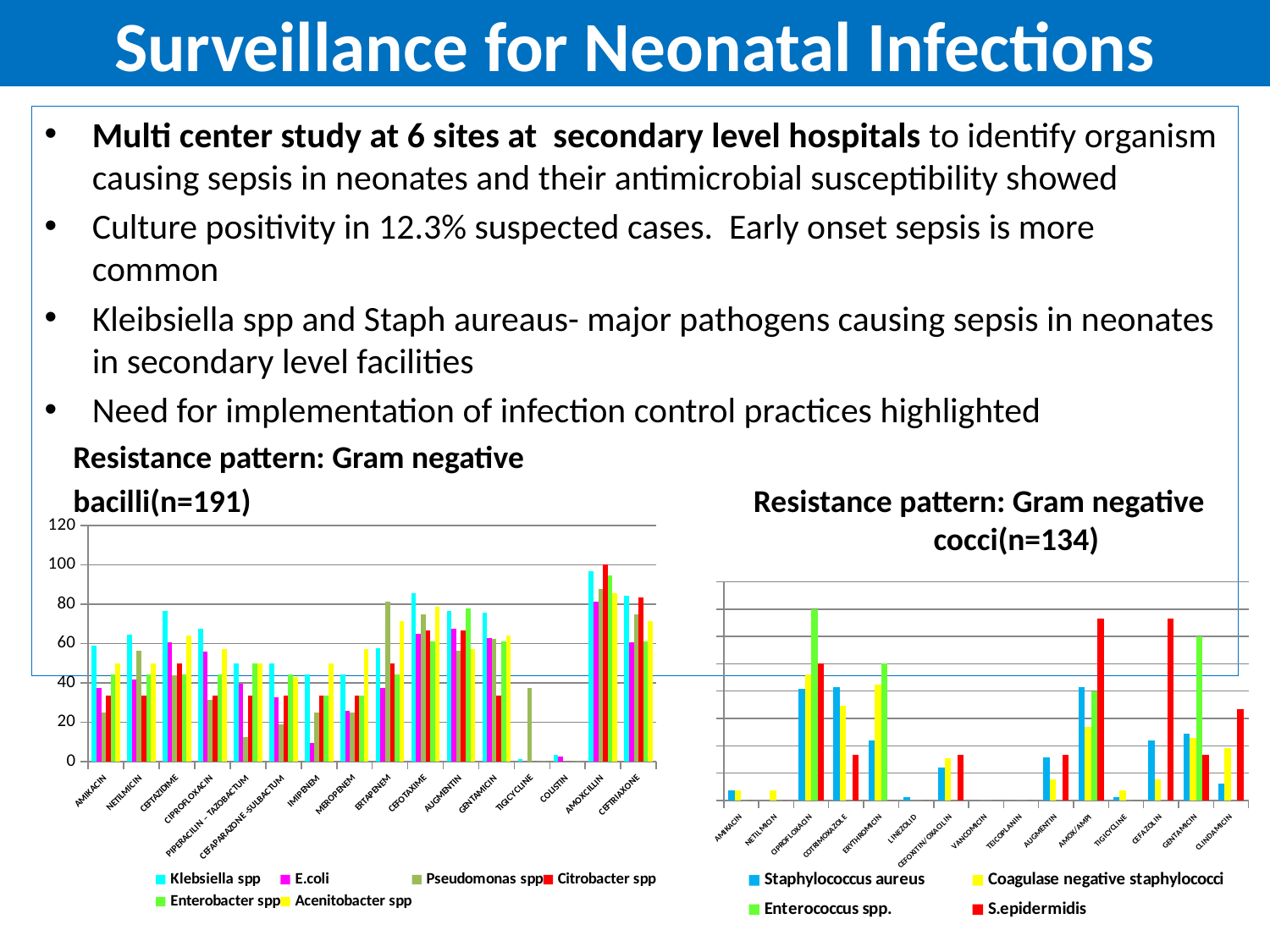
In the 'Resistance pattern: Gram negative bacilli(n=191)' chart, is the value for Klebsiella spp at CEFOTAXIME greater or less than 80? greater How many series does the legend of the 'Resistance pattern: Gram negative bacilli(n=191)' chart list? 6 What type of chart is the 'Resistance pattern: Gram negative bacilli(n=191)' chart? bar chart In the 'Resistance pattern: Gram negative bacilli(n=191)' chart, is the value for Citrobacter spp at AMOXCILLIN greater or less than 80? greater How many series does the legend of the 'Resistance pattern: Gram negative cocci(n=134)' chart list? 4 Which series is shown in red in the legend of the 'Resistance pattern: Gram negative cocci(n=134)' chart? S.epidermidis In the 'Resistance pattern: Gram negative bacilli(n=191)' chart, is the value for E.coli at IMIPENEM greater or less than 20? less How many antibiotic categories are shown on the x axis of the 'Resistance pattern: Gram negative cocci(n=134)' chart? 15 What is the highest value shown on the y axis of the 'Resistance pattern: Gram negative bacilli(n=191)' chart? 120 How many antibiotic categories are shown on the x axis of the 'Resistance pattern: Gram negative bacilli(n=191)' chart? 16